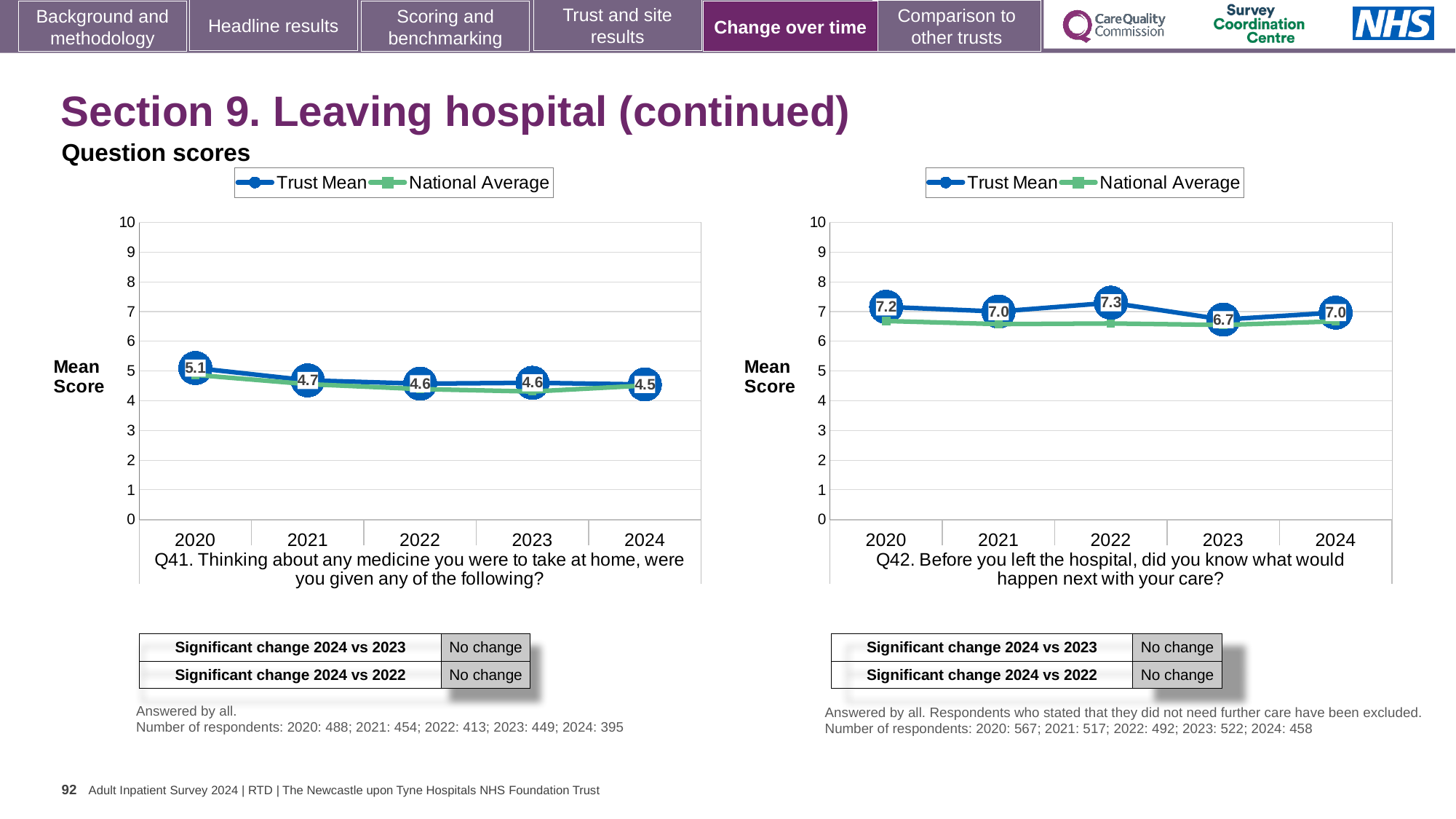
In the Q41 chart on the left, which year has the highest Trust Mean score? 2020 In the Q41 chart on the left, is the Trust Mean score for 2020 or 2024 larger? 2020 In the Q42 chart on the right, what is the Trust Mean score for 2022? 7.3 How many years are plotted on the x axis of the Q41 chart on the left? 5 In the Q42 chart on the right, which year has the lowest Trust Mean score? 2023 In the Q42 chart on the right, what is the Trust Mean score for 2023? 6.7 In the Q41 chart on the left, what is the Trust Mean score for 2020? 5.1 In the Q42 chart on the right, is the National Average value for 2020 greater or less than 6? greater How many series does the legend of the Q42 chart on the right list? 2 In the Q42 chart on the right, what is the difference between the Trust Mean scores for 2022 and 2023? 0.6 In the Q41 chart on the left, what is the Trust Mean score for 2024? 4.5 What kind of chart is the Q41 chart on the left? Line chart